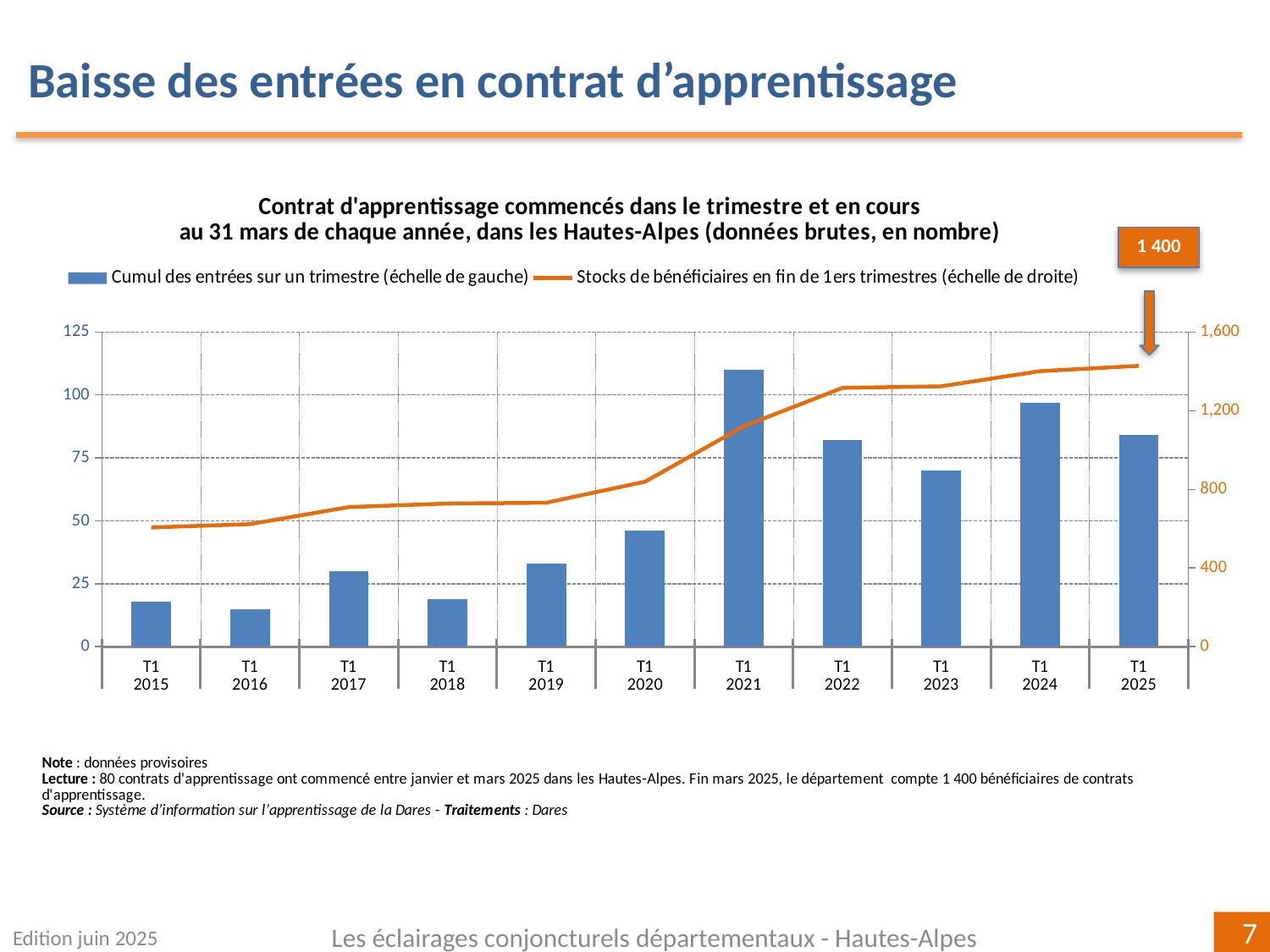
How many series does the legend list? 2 How many quarters (T1 categories) are shown on the x axis? 11 Which series is plotted on the right-hand axis (échelle de droite)? Stocks de bénéficiaires en fin de 1ers trimestres Is the stock value (orange line) for T1 2015 greater or less than 800? less Does the orange line 'Stocks de bénéficiaires' generally rise or fall from T1 2015 to T1 2025? rise Which bar is taller, T1 2022 or T1 2023? T1 2022 What kind of chart is shown on the slide? A combined bar and line chart Is the bar value for T1 2023 greater or less than 75? less What is the labelled value of 'Stocks de bénéficiaires en fin de 1ers trimestres' at T1 2025? 1 400 Is the bar value for T1 2020 greater or less than 50? less Which quarter has the highest bar for 'Cumul des entrées sur un trimestre'? T1 2021